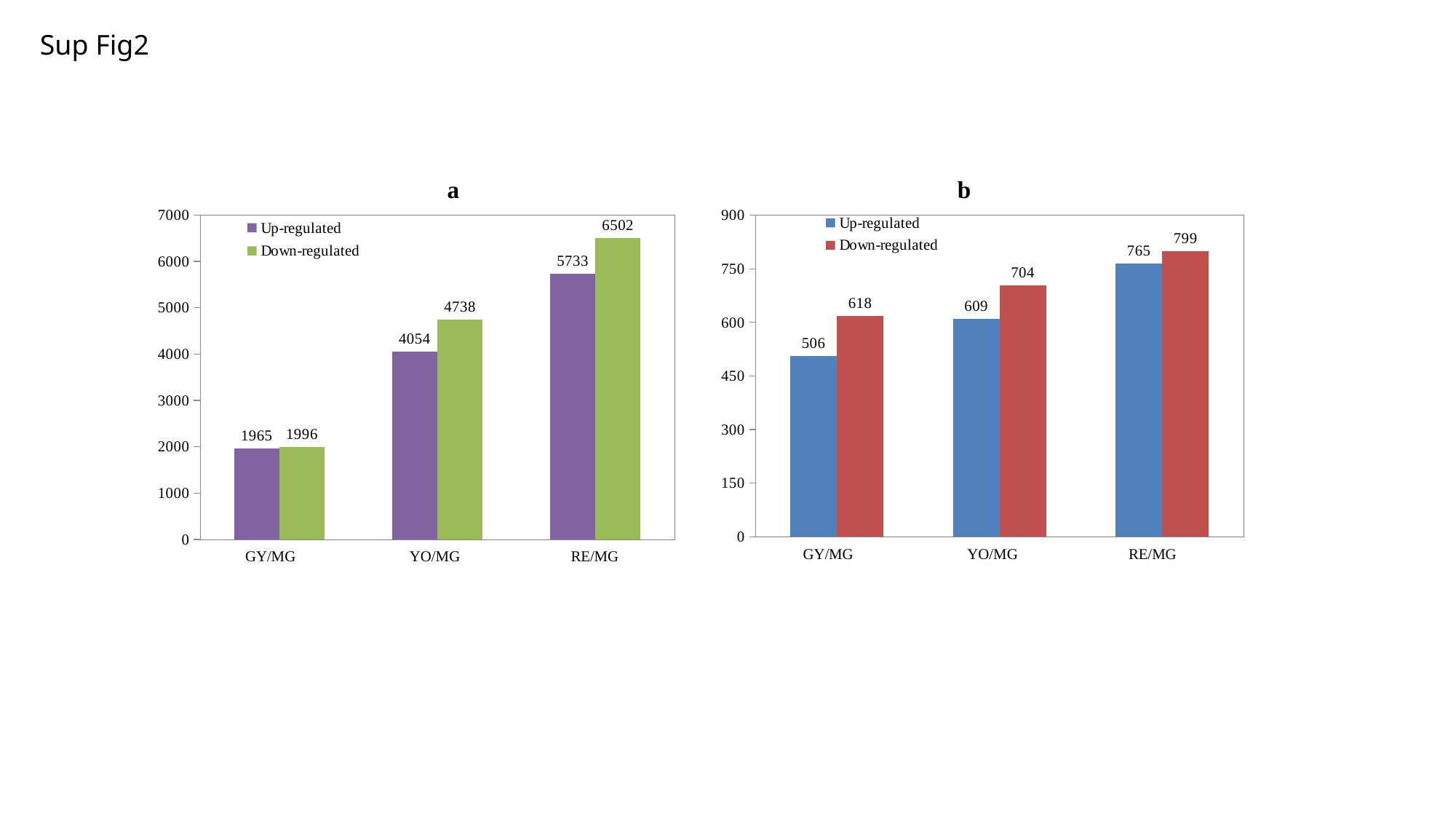
How many series does the legend of chart a list? 2 In chart b, what is the Down-regulated value for YO/MG? 704 In chart a, which is larger for YO/MG: the Up-regulated or the Down-regulated value? Down-regulated In chart a, which category has the highest Down-regulated value? RE/MG In chart a, what is the Down-regulated value for RE/MG? 6502 In chart b, what is the Up-regulated value for GY/MG? 506 In chart a, what is the difference between the Down-regulated and Up-regulated values for RE/MG? 769 How many categories are shown on the x axis of chart b? 3 In chart a, what is the Up-regulated value for YO/MG? 4054 In chart b, which category has the lowest Up-regulated value? GY/MG What type of chart is chart b? Bar chart In chart b, what is the difference between the Down-regulated and Up-regulated values for GY/MG? 112